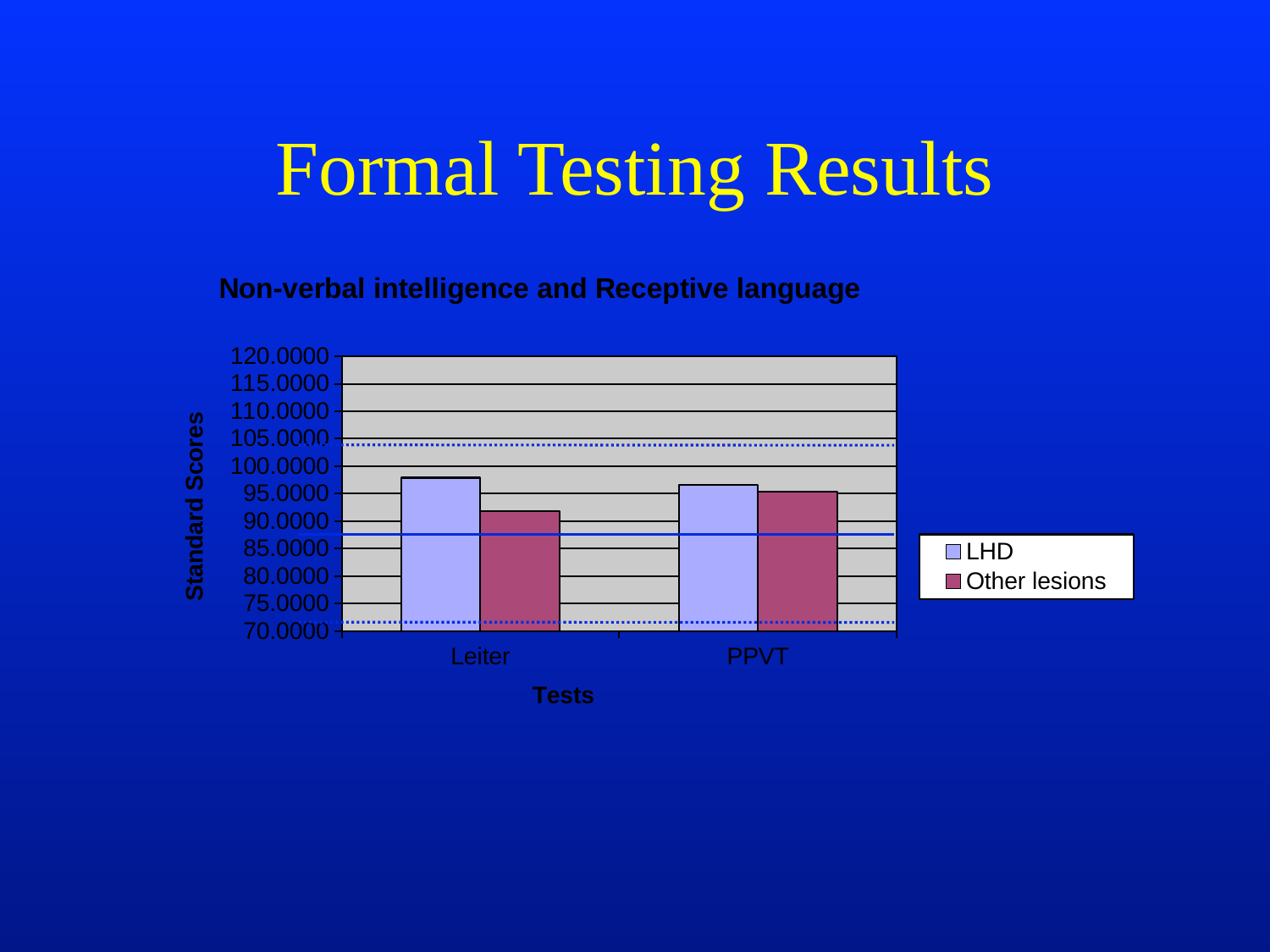
Which bar in the chart is the lowest? Other lesions for Leiter How many test categories are shown on the x axis? 2 Is the LHD value for PPVT greater or less than 100? less Is the Other lesions value for Leiter greater or less than 85? greater Does the Other lesions value rise or fall from Leiter to PPVT? rise For the Leiter test, which series has the larger value, LHD or Other lesions? LHD Is the LHD value for Leiter greater or less than 95? greater What kind of chart is shown on the slide? bar chart What is the label of the y axis? Standard Scores What is the title of the chart? Non-verbal intelligence and Receptive language How many series does the legend list? 2